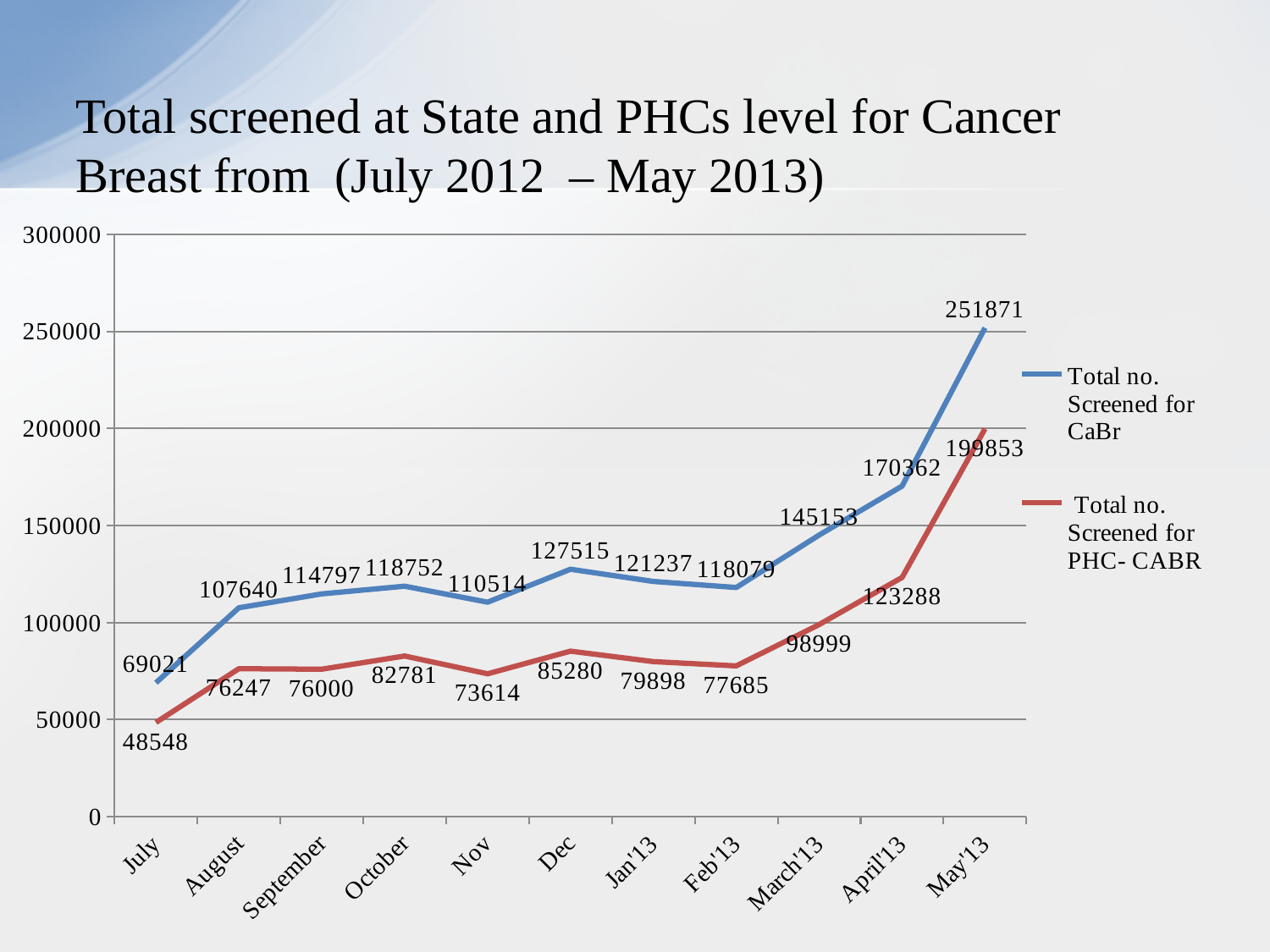
What is the difference between Total no. Screened for CaBr and Total no. Screened for PHC-CABR in April'13? 47074 Is the value for Total no. Screened for PHC-CABR in May'13 greater or less than 150000? greater In which month is Total no. Screened for PHC-CABR lowest? July What kind of chart is shown on the slide? line chart In which month is Total no. Screened for CaBr highest? May'13 How many series does the legend list? 2 What colour is the line for Total no. Screened for PHC-CABR? red What is the value for Total no. Screened for PHC-CABR in July? 48548 How many months are plotted along the x axis? 11 What is the value for Total no. Screened for CaBr in May'13? 251871 Which is larger in March'13: Total no. Screened for CaBr or Total no. Screened for PHC-CABR? Total no. Screened for CaBr What is the value for Total no. Screened for CaBr in Dec? 127515